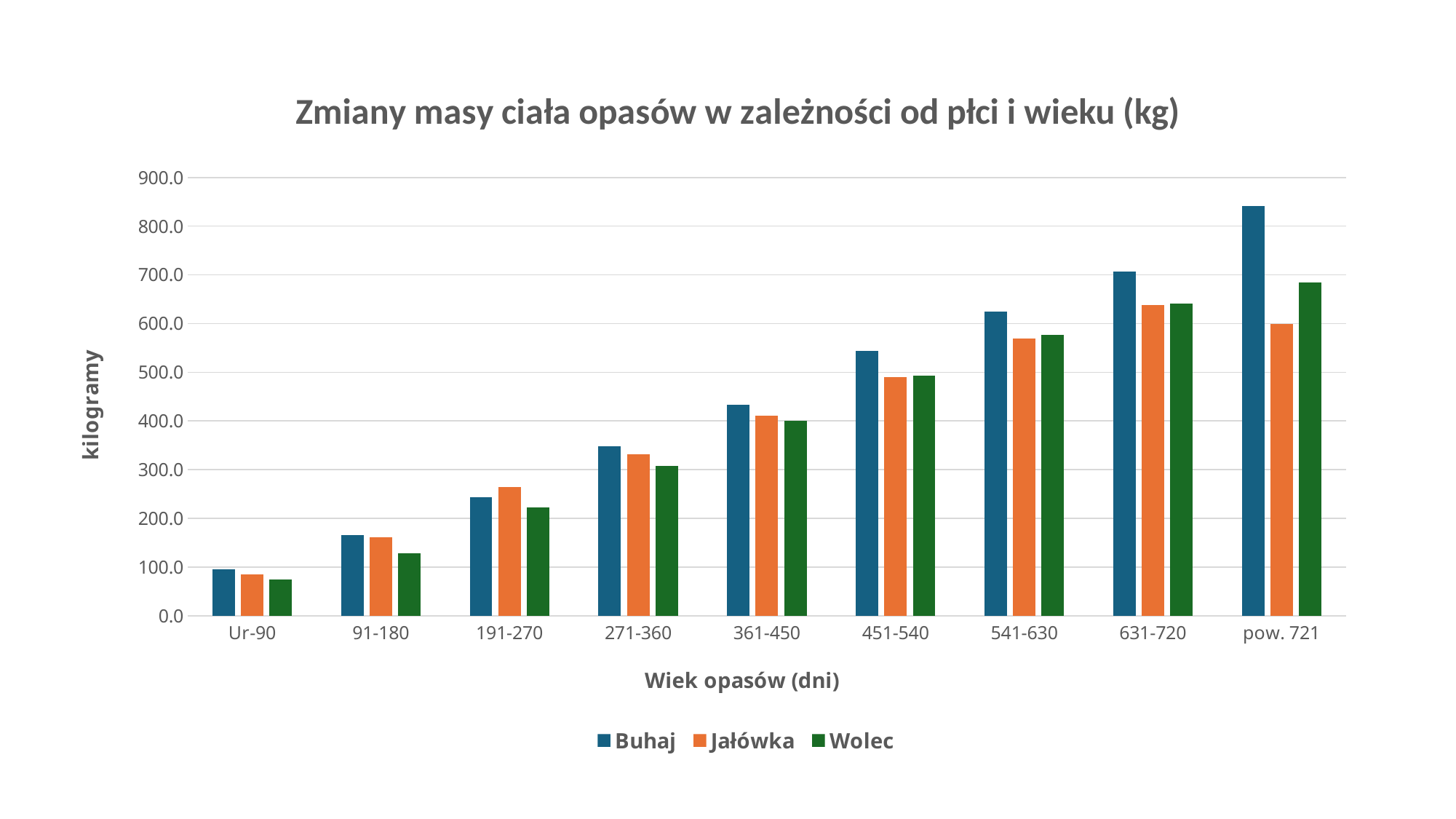
Is the value for Buhaj in the 361-450 group greater or less than 400.0? greater How many series does the legend list? 3 What kind of chart is shown on the slide? bar chart In the pow. 721 group, which is larger: Jałówka or Wolec? Wolec Is the value for Wolec in the 91-180 group greater or less than 100.0? greater Which age group has the lowest value for Wolec? Ur-90 What is the title of the y axis? kilogramy Is the value for Buhaj in the pow. 721 group greater or less than 800.0? greater In the 191-270 group, which is larger: Buhaj or Jałówka? Jałówka Which age group has the highest value for Buhaj? pow. 721 How many age groups are shown on the x axis? 9 Do the Buhaj values rise or fall as age increases along the x axis? rise